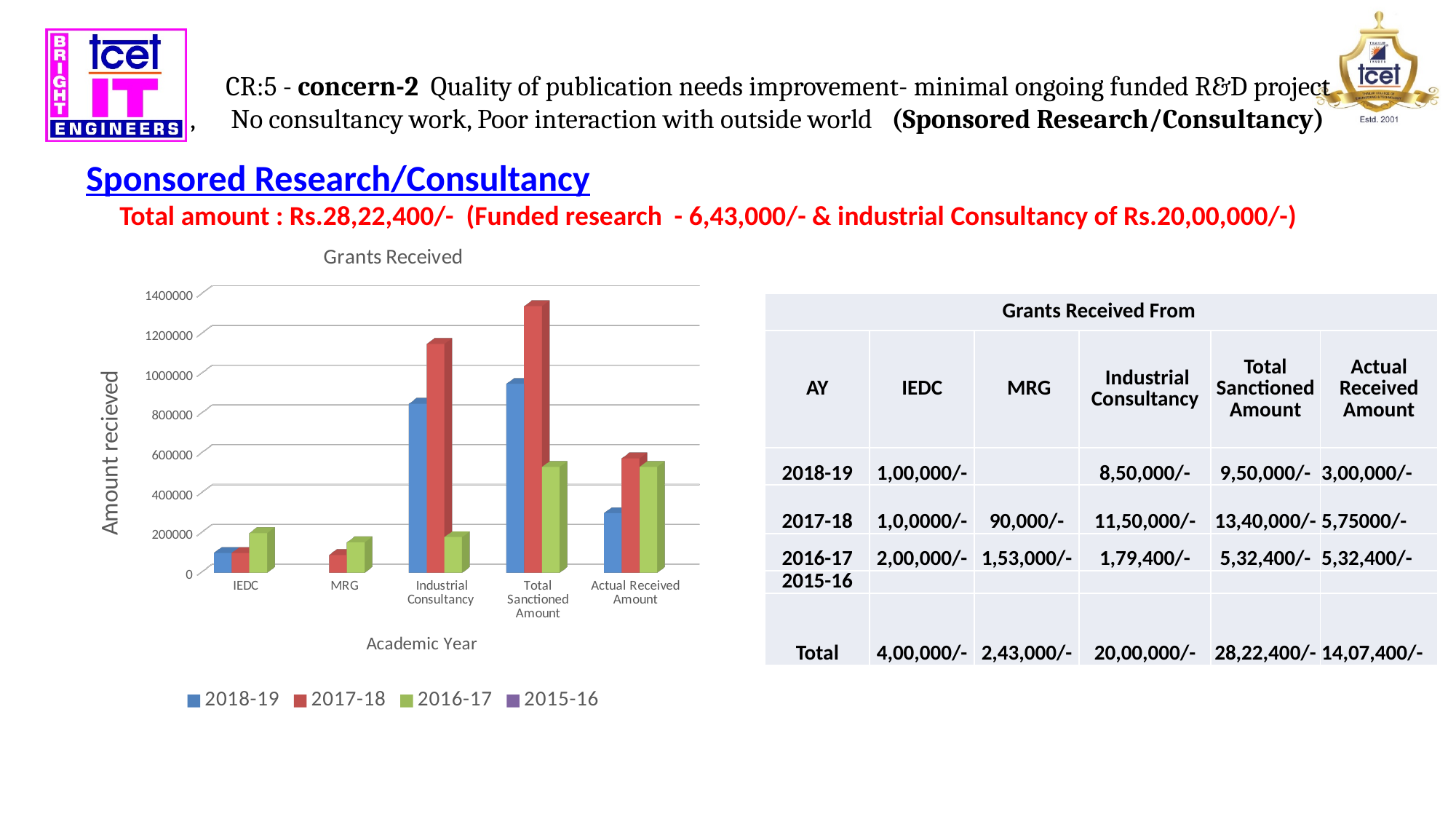
How many series does the legend of the "Grants Received" chart list? 4 In the "Grants Received" chart, which series has the highest bar for Industrial Consultancy? 2017-18 What type of chart is shown under the title "Grants Received"? bar chart How many categories are shown on the x axis of the "Grants Received" chart? 5 In the "Grants Received" chart, which category has the tallest bar overall? Total Sanctioned Amount What is the label on the vertical axis of the "Grants Received" chart? Amount recieved In the "Grants Received" chart, is the 2017-18 value for Total Sanctioned Amount greater or less than 1200000? greater In the "Grants Received" chart, which series has the highest bar for IEDC? 2016-17 In the "Grants Received" chart, is the 2017-18 value for Industrial Consultancy greater or less than 1000000? greater In the "Grants Received" chart, is the 2018-19 value for Actual Received Amount greater or less than 400000? less In the "Grants Received" chart, which is larger for 2018-19: Industrial Consultancy or Total Sanctioned Amount? Total Sanctioned Amount